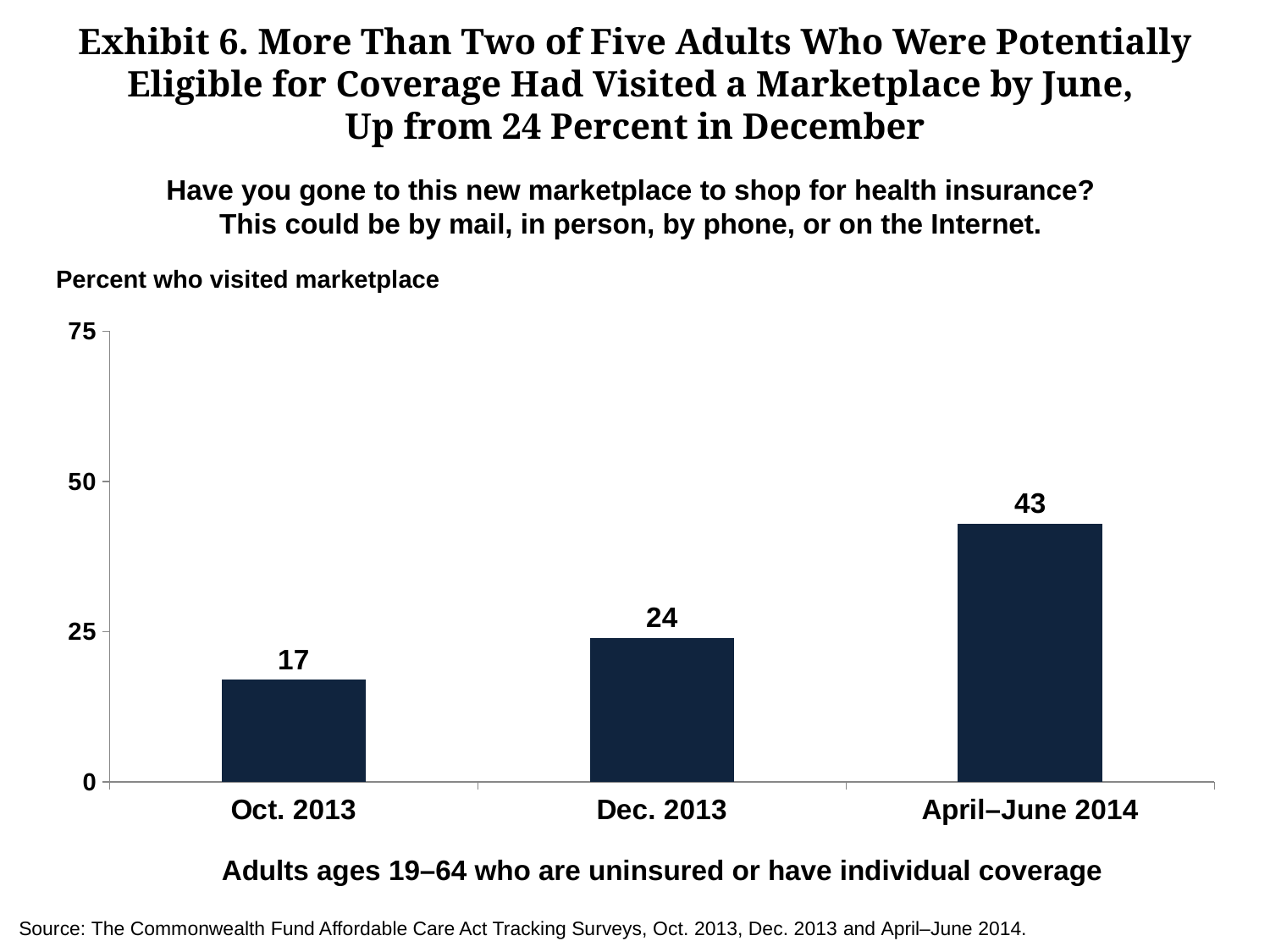
What percent visited the marketplace in April–June 2014? 43 How many time periods are shown on the chart? 3 Which is larger, the value for Oct. 2013 or the value for Dec. 2013? Dec. 2013 What is the difference between the Oct. 2013 and Dec. 2013 values? 7 Which period has the highest percent who visited the marketplace? April–June 2014 What percent of adults had visited a marketplace in Oct. 2013? 17 What is the value shown for Dec. 2013? 24 What kind of chart is shown on the slide? bar chart Which period has the lowest percent who visited the marketplace? Oct. 2013 By how many percentage points did the value increase from Dec. 2013 to April–June 2014? 19 Is the value for April–June 2014 greater or less than 50? less Do the values rise or fall from Oct. 2013 to April–June 2014? rise